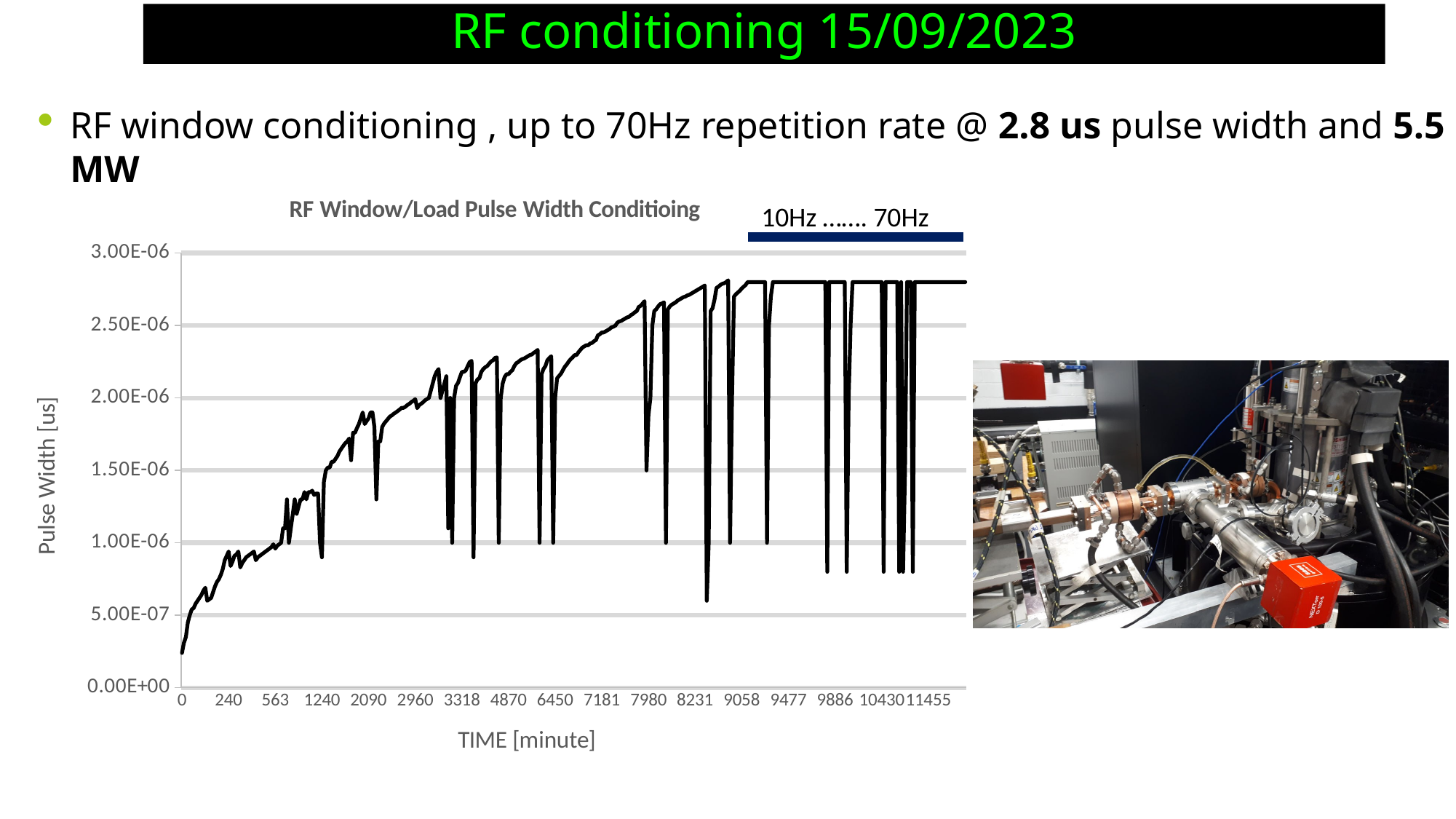
Is the pulse width at the final time 11455 greater or less than 2.50E-06? greater Is the pulse width at time 240 greater or less than 1.00E-06? less Is the pulse width at time 2090 greater or less than 1.50E-06? greater What is the title of the chart? RF Window/Load Pulse Width Conditioing How many tick labels are shown on the x axis of the chart? 17 What is the label of the y axis of the chart? Pulse Width [us] What kind of chart is shown on the slide? line chart How many data series are plotted in the chart? 1 What is the highest value shown on the y axis of the chart? 3.00E-06 Overall, does the pulse width rise or fall as time increases along the x axis? rise